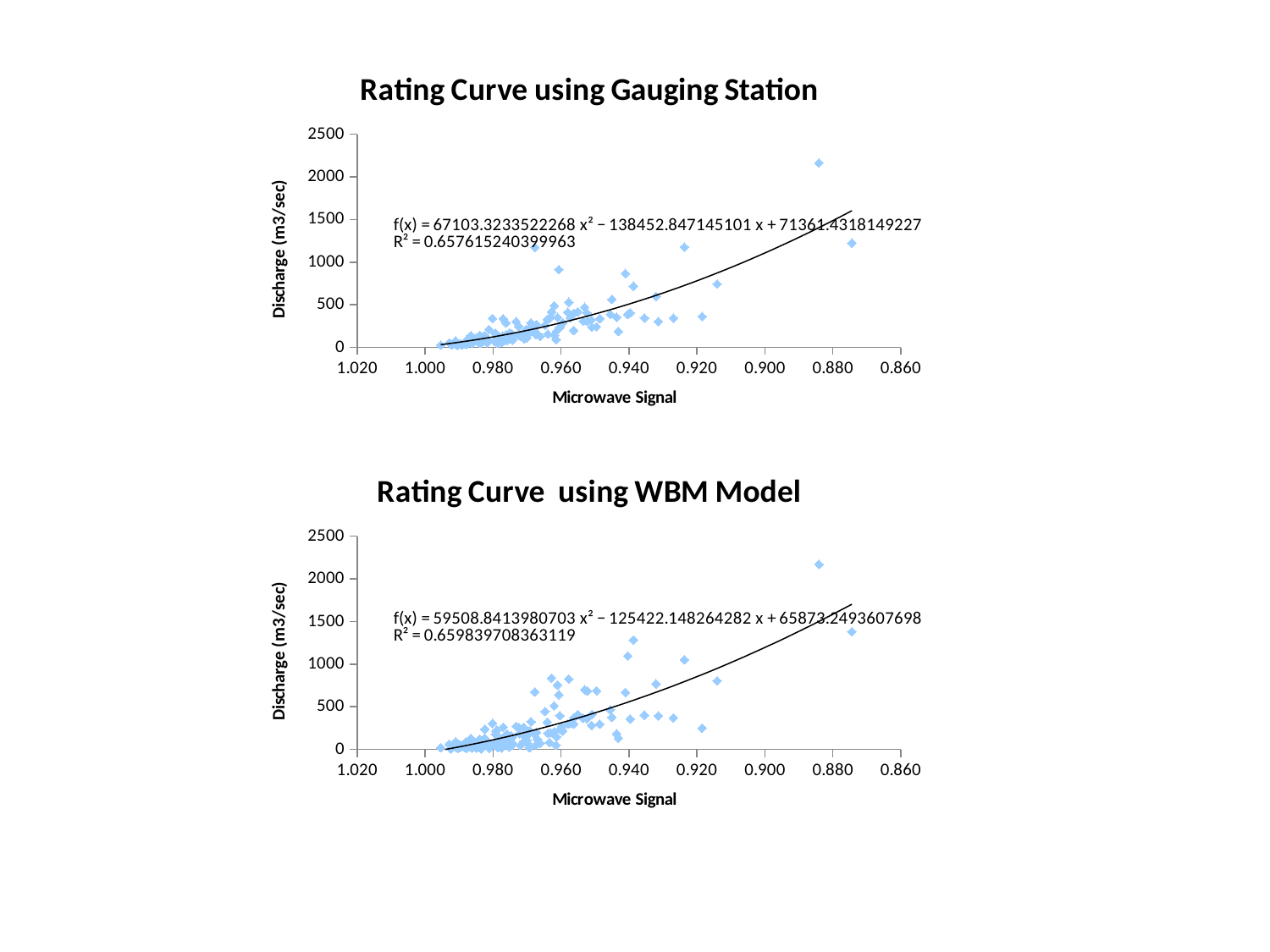
In the top chart 'Rating Curve using Gauging Station', is the discharge of the highest plotted point greater or less than 2000? greater What is the label of the y axis on the top chart 'Rating Curve using Gauging Station'? Discharge (m3/sec) In the bottom chart 'Rating Curve using WBM Model', what R² value is printed for the fitted curve? 0.659839708363119 Which chart has the higher printed R² value, 'Rating Curve using Gauging Station' or 'Rating Curve using WBM Model'? Rating Curve using WBM Model What kind of chart is the top chart titled 'Rating Curve using Gauging Station'? scatter chart In the top chart 'Rating Curve using Gauging Station', what R² value is printed for the fitted curve? 0.657615240399963 In the top chart 'Rating Curve using Gauging Station', does the fitted curve rise or fall moving from left to right along the x axis? rise In the bottom chart 'Rating Curve using WBM Model', does the fitted curve rise or fall moving from left to right along the x axis? rise In the top chart 'Rating Curve using Gauging Station', what is the highest value shown on the y axis? 2500 What is the title of the bottom chart on the slide? Rating Curve using WBM Model In the bottom chart 'Rating Curve using WBM Model', is the discharge of the highest plotted point greater or less than 2000? greater How many charts are shown on the slide? 2